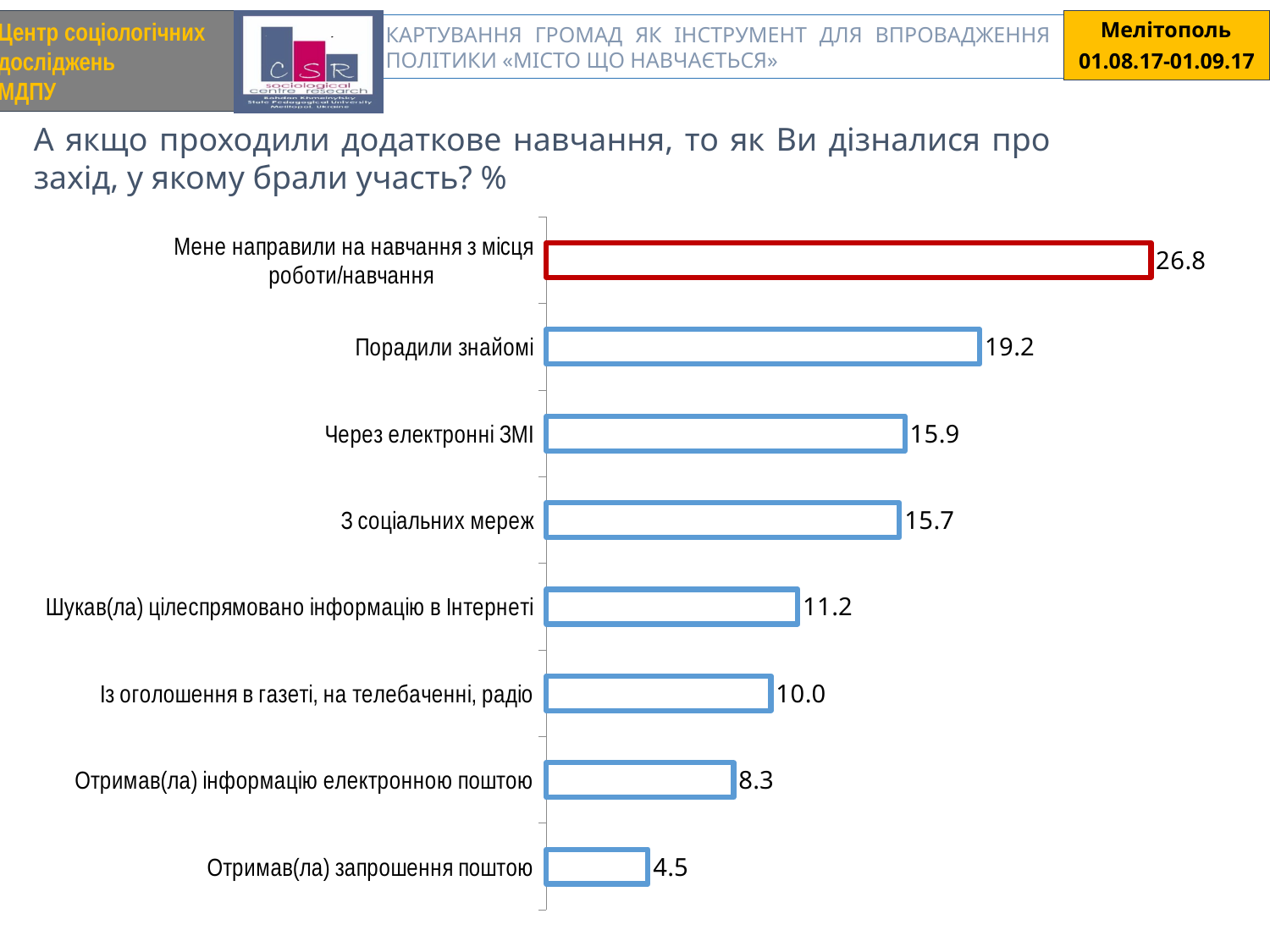
What is the value for "Мене направили на навчання з місця роботи/навчання"? 26.8 What is the value for "Через електронні ЗМІ"? 15.9 What kind of chart is shown on the slide? Bar chart What is the difference between the highest and lowest values in the chart? 22.3 What is the value for "Отримав(ла) інформацію електронною поштою"? 8.3 Which bar is outlined in red rather than blue? Мене направили на навчання з місця роботи/навчання Which category has the lowest value? Отримав(ла) запрошення поштою Which category has the highest value? Мене направили на навчання з місця роботи/навчання How many categories are shown in the chart? 8 What is the difference between the values for "Порадили знайомі" and "Шукав(ла) цілеспрямовано інформацію в Інтернеті"? 8.0 What is the value for "Порадили знайомі"? 19.2 Which is larger: the value for "З соціальних мереж" or the value for "Із оголошення в газеті, на телебаченні, радіо"? З соціальних мереж